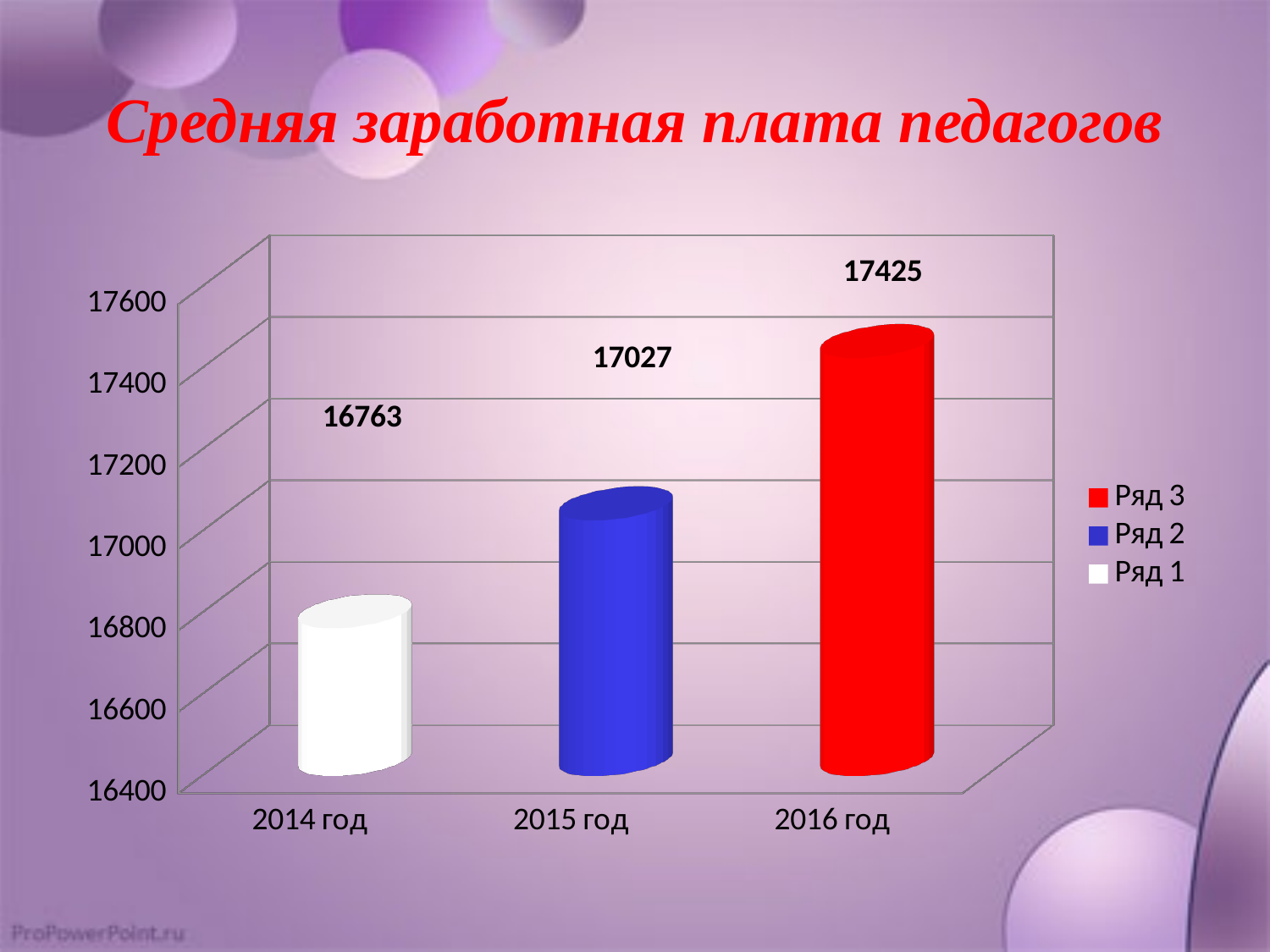
What is the difference between the values for 2015 год and 2014 год? 264 What is the value for 2015 год? 17027 What is the difference between the values for 2016 год and 2015 год? 398 Which year has the highest value? 2016 год What is the value for 2014 год? 16763 What kind of chart is shown on the slide? bar chart What is the value for 2016 год? 17425 Is the value for 2016 год greater or less than 17400? greater Which is larger, the value for 2014 год or the value for 2015 год? 2015 год How many series does the legend list? 3 Which year has the lowest value? 2014 год How many categories are shown on the x axis? 3